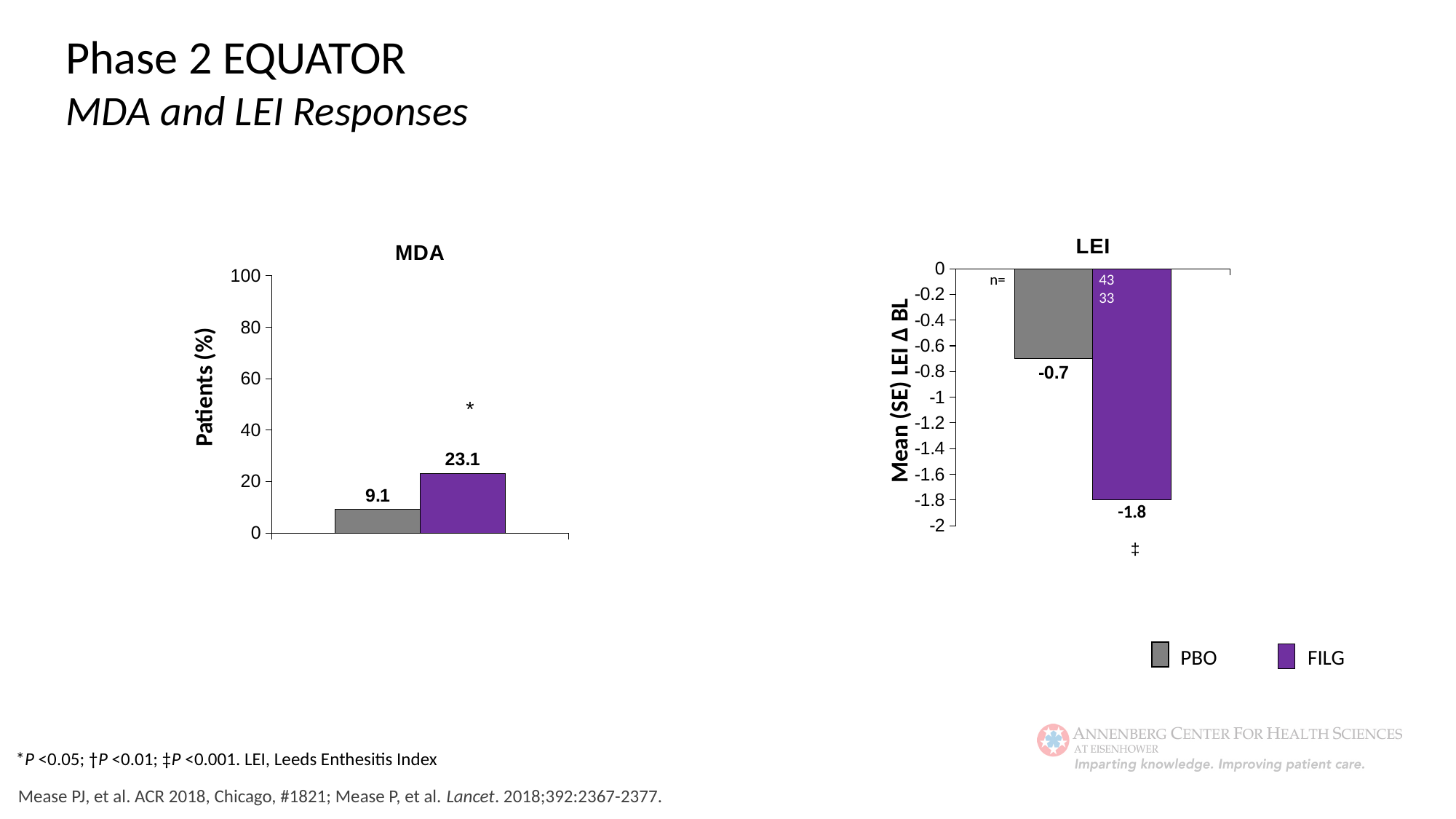
What is the y-axis label of the LEI chart? Mean (SE) LEI Δ BL In the MDA chart, which group has the higher value, PBO or FILG? FILG In the MDA chart, is the value for FILG greater or less than 40? less In the MDA chart, what is the difference between the FILG and PBO values? 14 How many series does the legend list? 2 In the MDA chart, what percentage of patients is shown for FILG? 23.1 In the LEI chart, which group shows the larger decrease from baseline? FILG What kind of chart is the MDA chart? bar chart In the LEI chart, what is the mean change from baseline for FILG? -1.8 In the MDA chart, what percentage of patients is shown for PBO? 9.1 In the LEI chart, what is the difference between the PBO and FILG values? 1.1 In the LEI chart, what is the mean change from baseline for PBO? -0.7